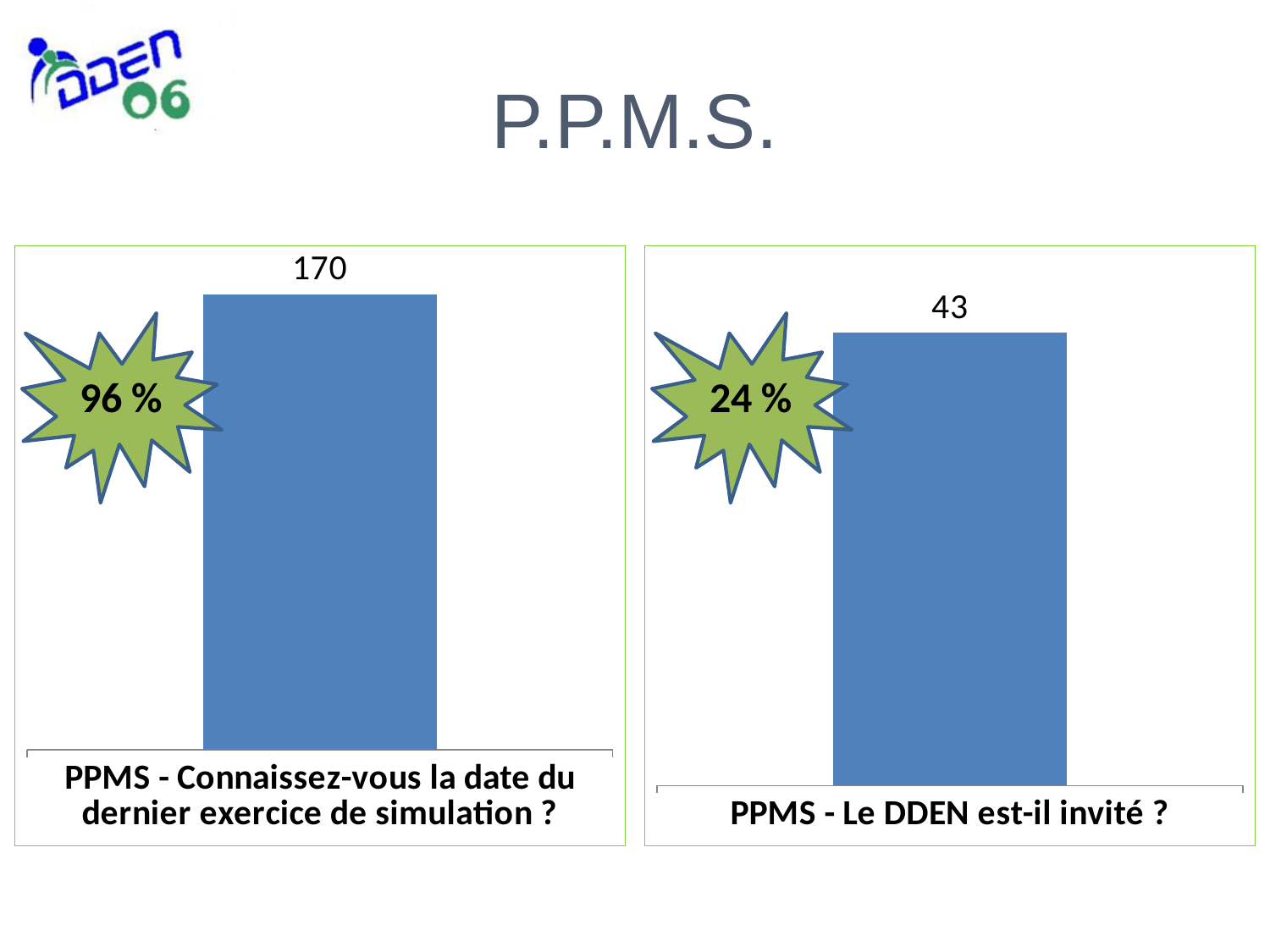
What kind of chart is the left chart, "PPMS - Connaissez-vous la date du dernier exercice de simulation ?"? bar chart In the right chart titled "PPMS - Le DDEN est-il invité ?", what value is printed above the bar? 43 What is the difference between the bar value in the left chart (170) and the bar value in the right chart (43)? 127 What percentage is shown in the green starburst on the right chart, "PPMS - Le DDEN est-il invité ?"? 24 % What percentage is shown in the green starburst on the left chart, "PPMS - Connaissez-vous la date du dernier exercice de simulation ?"? 96 % How many bars are plotted in the left chart, "PPMS - Connaissez-vous la date du dernier exercice de simulation ?"? 1 How many bars are plotted in the right chart, "PPMS - Le DDEN est-il invité ?"? 1 What kind of chart is the right chart, "PPMS - Le DDEN est-il invité ?"? bar chart How many charts are shown on the slide? 2 In the left chart titled "PPMS - Connaissez-vous la date du dernier exercice de simulation ?", what value is printed above the bar? 170 Which chart shows the larger bar value: the left chart ("Connaissez-vous la date du dernier exercice de simulation ?") or the right chart ("Le DDEN est-il invité ?")? the left chart